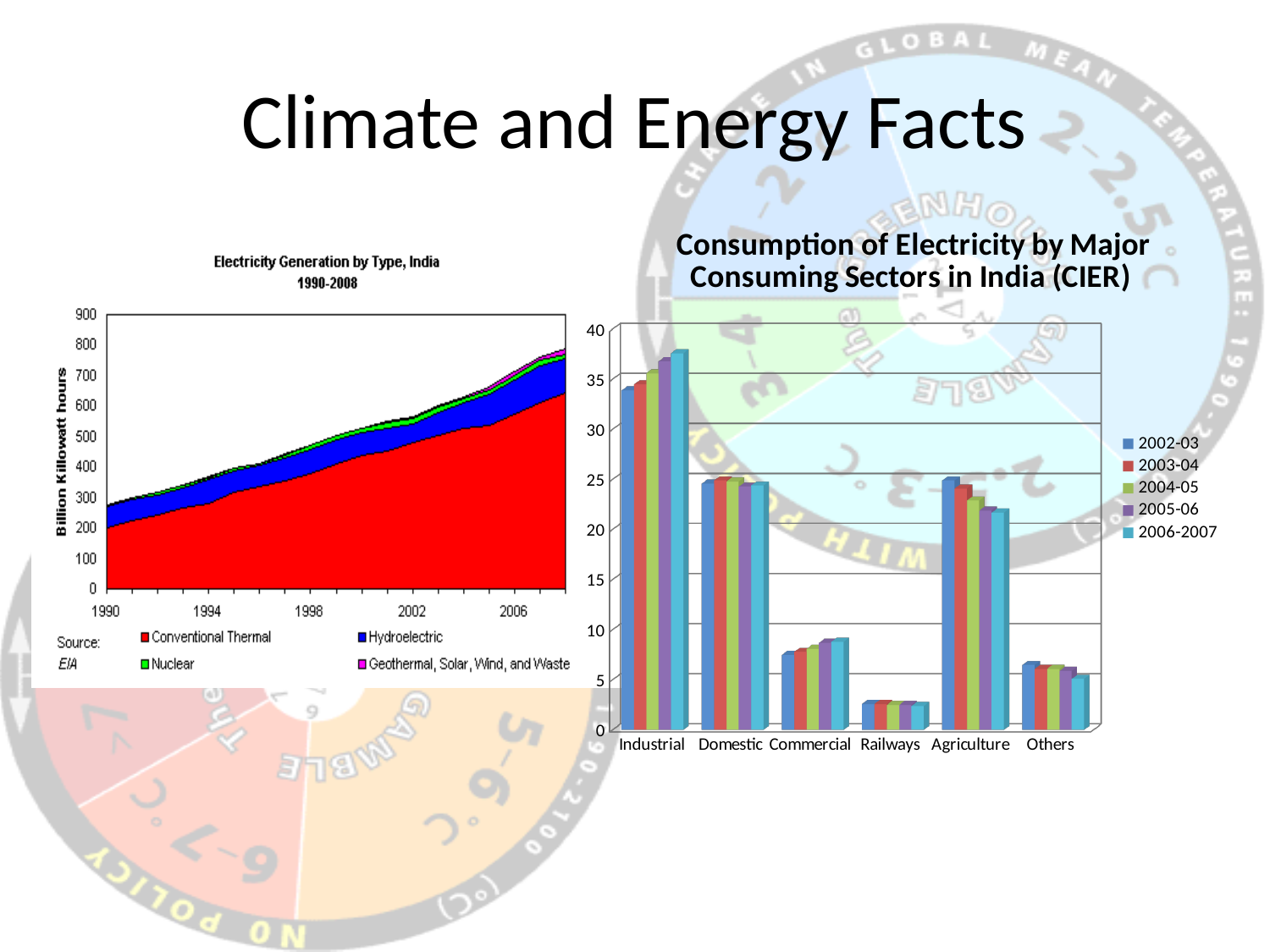
What kind of chart is the 'Electricity Generation by Type, India 1990-2008' chart? area chart In the 'Consumption of Electricity by Major Consuming Sectors in India (CIER)' chart, which is larger for 2002-03: Domestic or Commercial? Domestic In the 'Consumption of Electricity by Major Consuming Sectors in India (CIER)' chart, which sector has the lowest values? Railways In the 'Consumption of Electricity by Major Consuming Sectors in India (CIER)' chart, is the 2006-2007 value for Industrial greater or less than 35? greater What is the y-axis label of the 'Electricity Generation by Type, India 1990-2008' chart? Billion Kilowatt hours What kind of chart is the 'Consumption of Electricity by Major Consuming Sectors in India (CIER)' chart? bar chart In the 'Consumption of Electricity by Major Consuming Sectors in India (CIER)' chart, do the Agriculture values rise or fall from 2002-03 to 2006-2007? fall In the 'Consumption of Electricity by Major Consuming Sectors in India (CIER)' chart, is the 2002-03 value for Railways greater or less than 5? less How many series does the legend of the 'Electricity Generation by Type, India 1990-2008' chart list? 4 How many series does the legend of the 'Consumption of Electricity by Major Consuming Sectors in India (CIER)' chart list? 5 How many sector categories are shown on the x axis of the 'Consumption of Electricity by Major Consuming Sectors in India (CIER)' chart? 6 In the 'Consumption of Electricity by Major Consuming Sectors in India (CIER)' chart, which sector has the highest values? Industrial